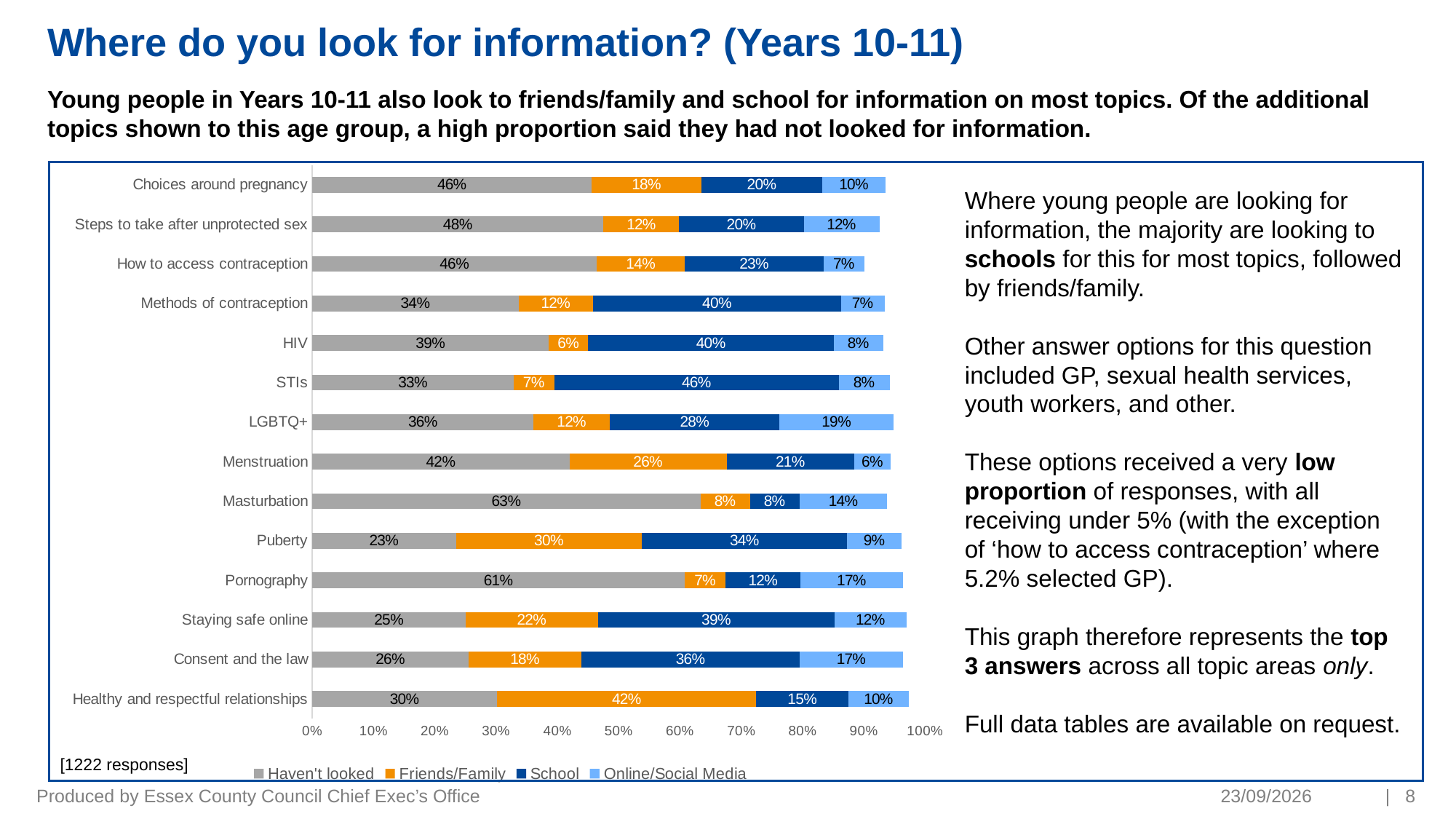
For HIV, which is larger: the School percentage or the Friends/Family percentage? School How many series does the chart legend list? 4 What percentage look to School for information on STIs? 46% How many topics (categories) are plotted in the chart? 14 Which topic has the lowest 'Haven't looked' percentage? Puberty What percentage look to Friends/Family for information on Healthy and respectful relationships? 42% What is the total of the four labelled segments for the Puberty bar? 96% What type of chart is shown on the slide? Stacked bar chart Which topic has the highest 'Haven't looked' percentage? Masturbation What percentage of Year 10-11 respondents said they haven't looked for information on Masturbation? 63% What is the difference in percentage points between the 'Haven't looked' values for Masturbation and Puberty? 40 percentage points What percentage look to Online/Social Media for information on LGBTQ+? 19%